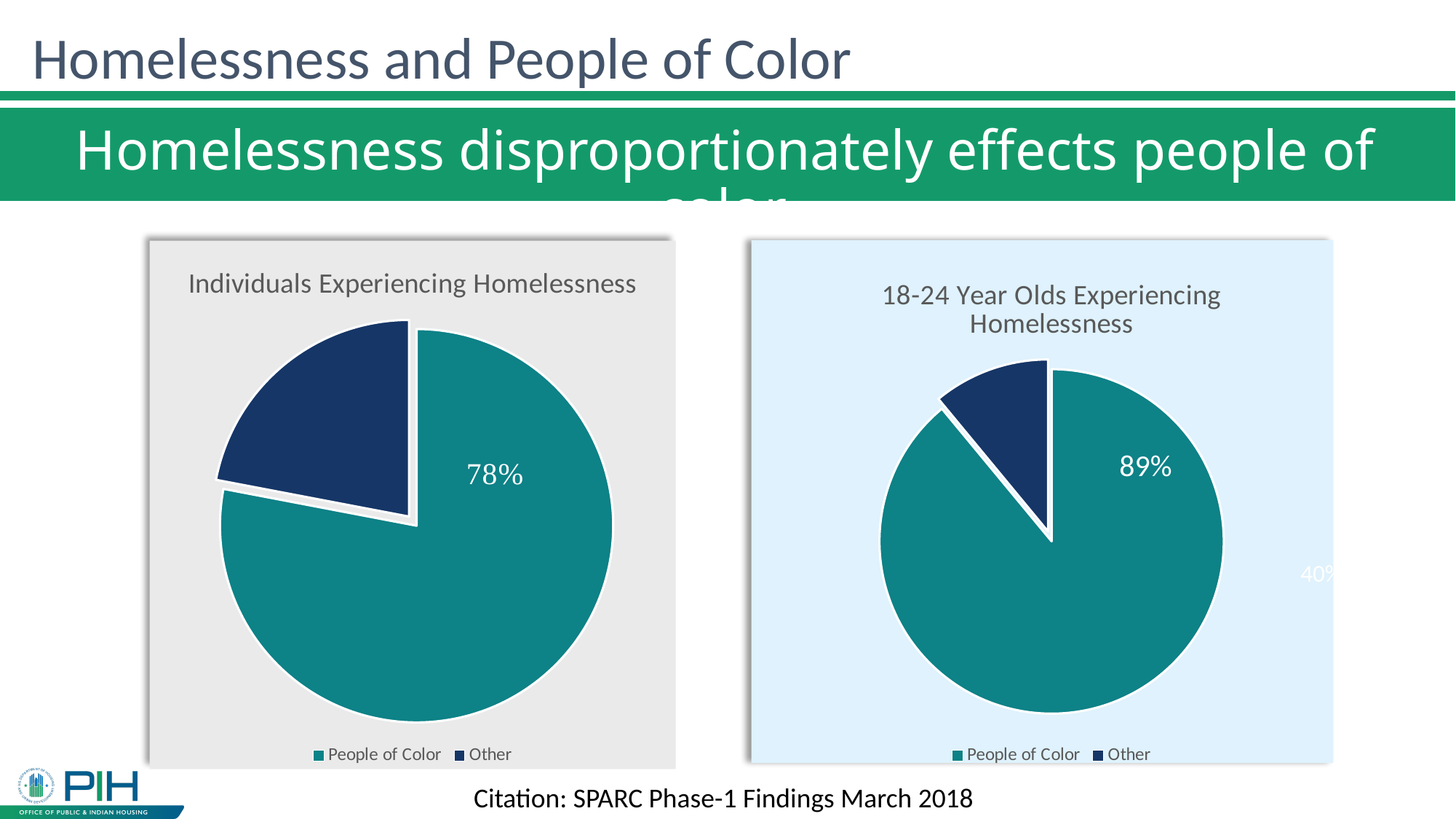
Is the People of Color share larger in the 'Individuals Experiencing Homelessness' chart or in the '18-24 Year Olds Experiencing Homelessness' chart? 18-24 Year Olds Experiencing Homelessness In the 'Individuals Experiencing Homelessness' chart, what share of the pie is People of Color? 78% In the '18-24 Year Olds Experiencing Homelessness' chart, which slice is the smallest? Other How many slices does the '18-24 Year Olds Experiencing Homelessness' pie have? 2 What is the title of the pie chart on the left of the slide? Individuals Experiencing Homelessness In the '18-24 Year Olds Experiencing Homelessness' chart, which legend entry is shown in dark navy blue? Other What kind of chart is the '18-24 Year Olds Experiencing Homelessness' chart? Pie chart How many entries does the legend of the 'Individuals Experiencing Homelessness' chart list? 2 What is the difference in percentage points between the People of Color share in the '18-24 Year Olds Experiencing Homelessness' chart and in the 'Individuals Experiencing Homelessness' chart? 11 percentage points In the 'Individuals Experiencing Homelessness' chart, which slice is the largest? People of Color In the '18-24 Year Olds Experiencing Homelessness' chart, what share of the pie is People of Color? 89% What kind of chart is the 'Individuals Experiencing Homelessness' chart? Pie chart